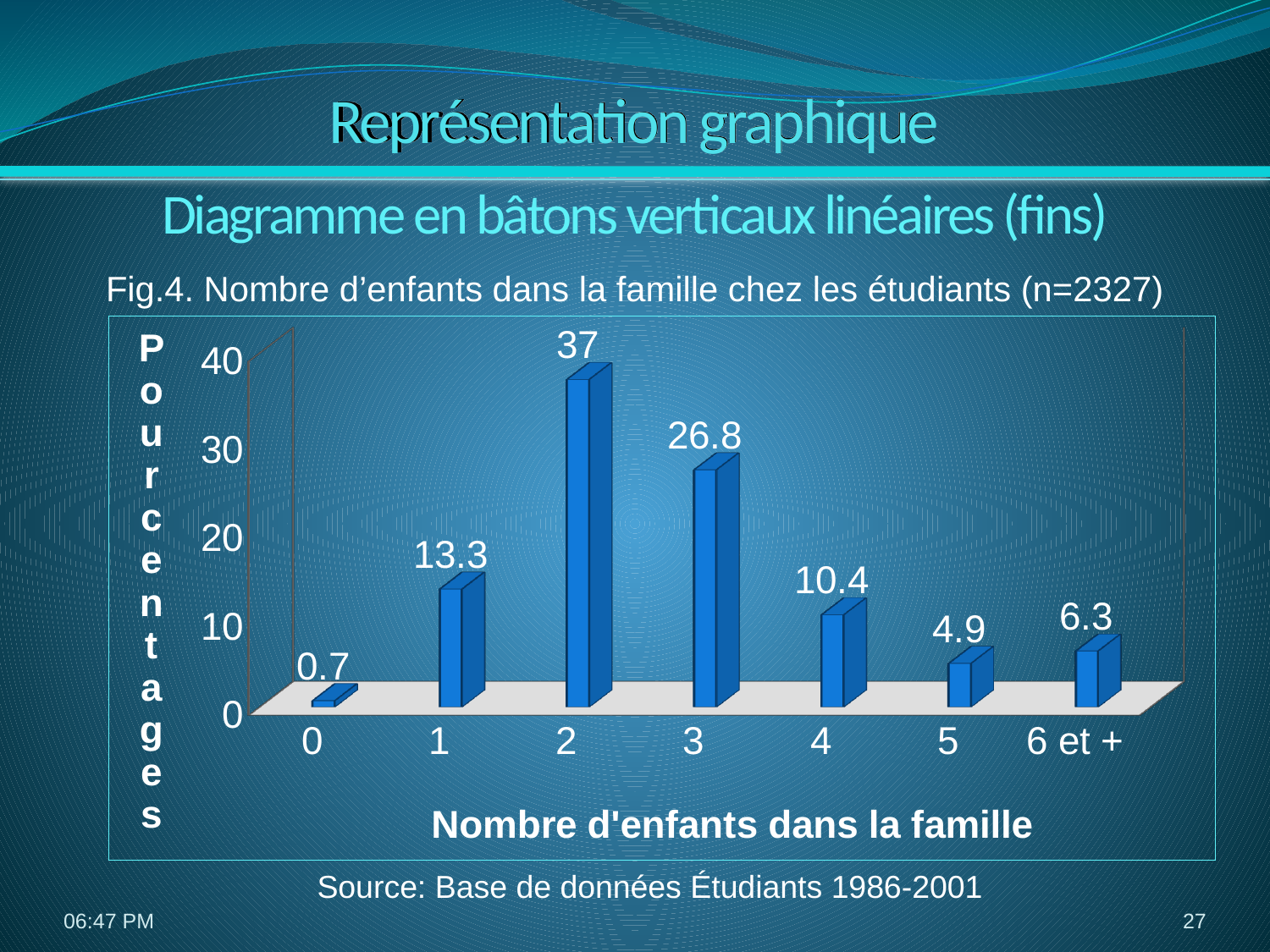
What is the percentage for the category '6 et +'? 6.3 What is the percentage for families with 0 children? 0.7 What kind of chart is shown? Bar chart What is the sample size (n) given in the figure caption? 2327 Which number of children has the highest percentage? 2 Which number of children has the lowest percentage? 0 What is the percentage for families with 2 children? 37 Is the value for 3 children greater or less than 20? greater What is the difference between the percentages for 2 children and 3 children? 10.2 How many categories are shown on the x axis? 7 Which is larger, the percentage for 1 child or for 4 children? 1 child What is the x-axis title of the chart? Nombre d'enfants dans la famille